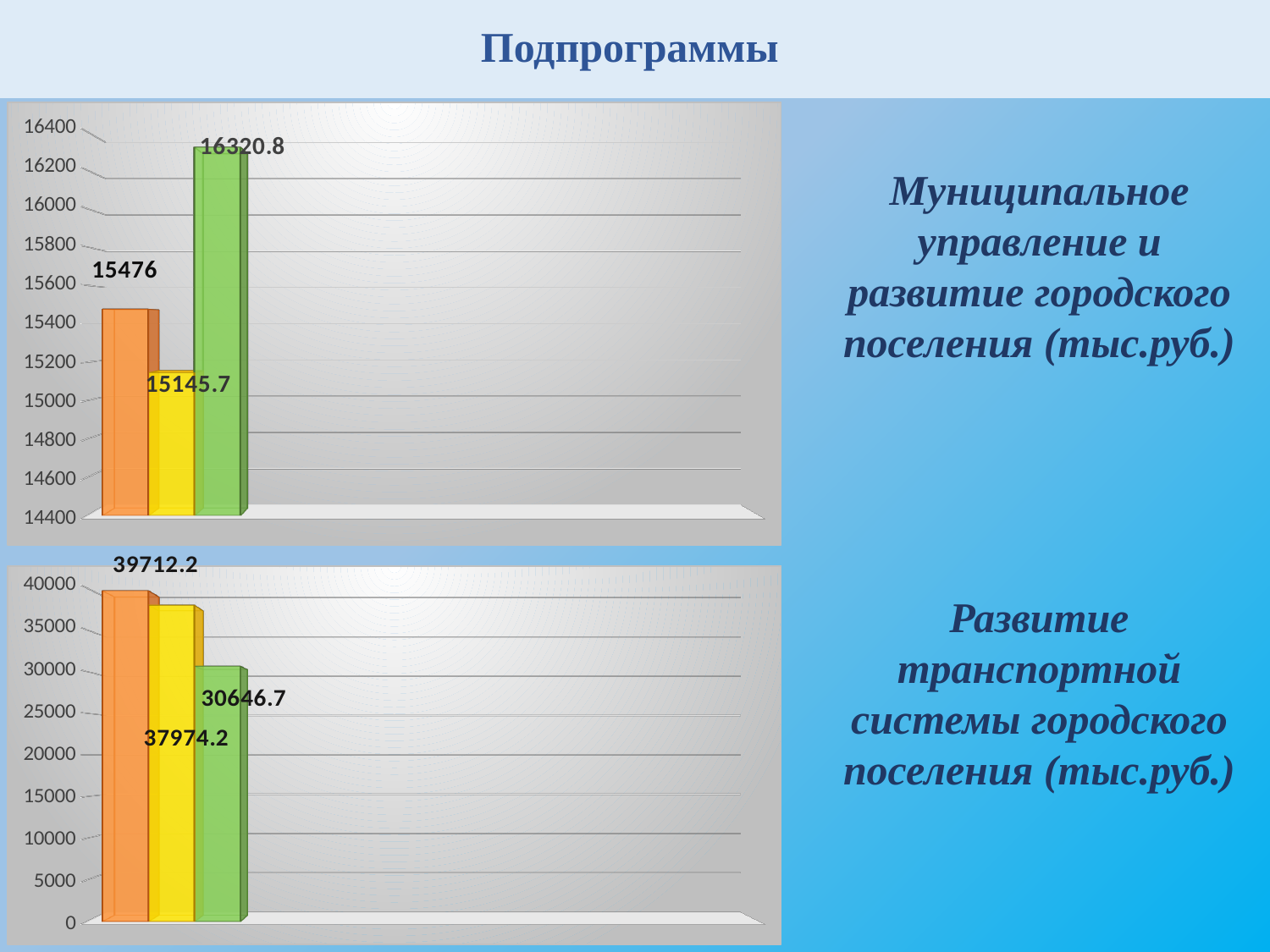
In the bottom chart (Развитие транспортной системы городского поселения), which coloured bar has the highest value? orange In the bottom chart (Развитие транспортной системы городского поселения), what is the value of the yellow bar? 37974.2 In the top chart (Муниципальное управление и развитие городского поселения), which coloured bar has the lowest value? yellow In the top chart (Муниципальное управление и развитие городского поселения), is the value of the orange bar greater or less than 15400? greater What kind of chart is the bottom chart (Развитие транспортной системы городского поселения)? bar chart In the bottom chart (Развитие транспортной системы городского поселения), do the bar values rise or fall from left to right? fall In the top chart (Муниципальное управление и развитие городского поселения), what is the value of the orange bar? 15476 In the top chart (Муниципальное управление и развитие городского поселения), what is the value of the green bar? 16320.8 In the bottom chart (Развитие транспортной системы городского поселения), which is larger, the yellow bar or the green bar? yellow In the bottom chart (Развитие транспортной системы городского поселения), what is the difference between the orange bar and the green bar? 9065.5 How many bars are plotted in the top chart (Муниципальное управление и развитие городского поселения)? 3 In the top chart (Муниципальное управление и развитие городского поселения), what is the difference between the green bar and the yellow bar? 1175.1